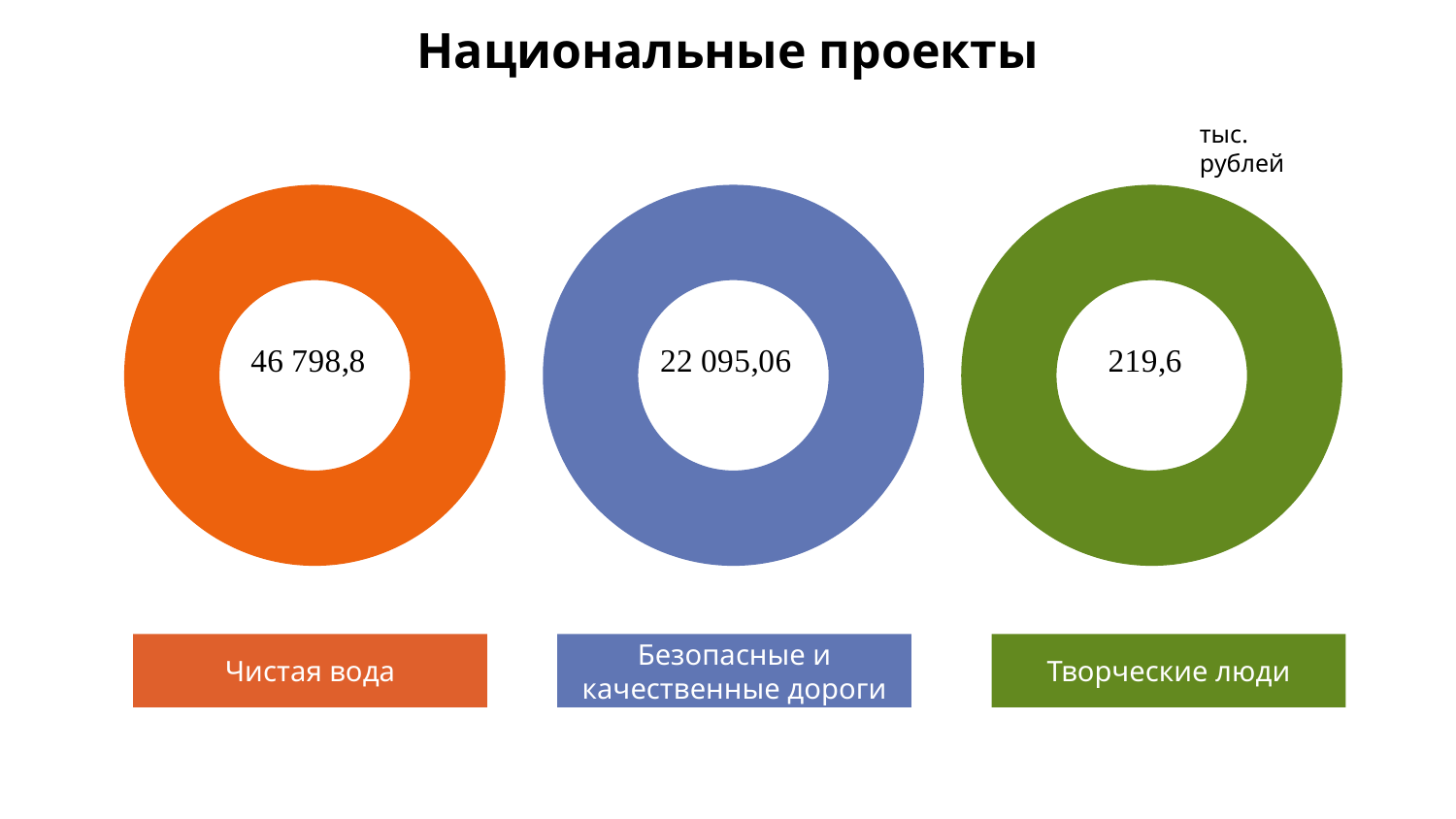
What value is shown in the centre of the 'Чистая вода' doughnut chart? 46 798,8 What value is shown in the centre of the 'Творческие люди' doughnut chart? 219,6 What is the difference between the value for 'Чистая вода' and the value for 'Безопасные и качественные дороги'? 24 703,74 What is the title of the slide? Национальные проекты Which of the three national projects has the highest value? Чистая вода What value is shown in the centre of the 'Безопасные и качественные дороги' doughnut chart? 22 095,06 Which of the three national projects has the lowest value? Творческие люди Which is larger: the value for 'Чистая вода' or the value for 'Безопасные и качественные дороги'? Чистая вода How many doughnut charts are shown on the slide? 3 What is the difference between the value for 'Безопасные и качественные дороги' and the value for 'Творческие люди'? 21 875,46 What kind of chart is used to display each national project's value? Doughnut chart In what units are the values on the slide expressed? тыс. рублей